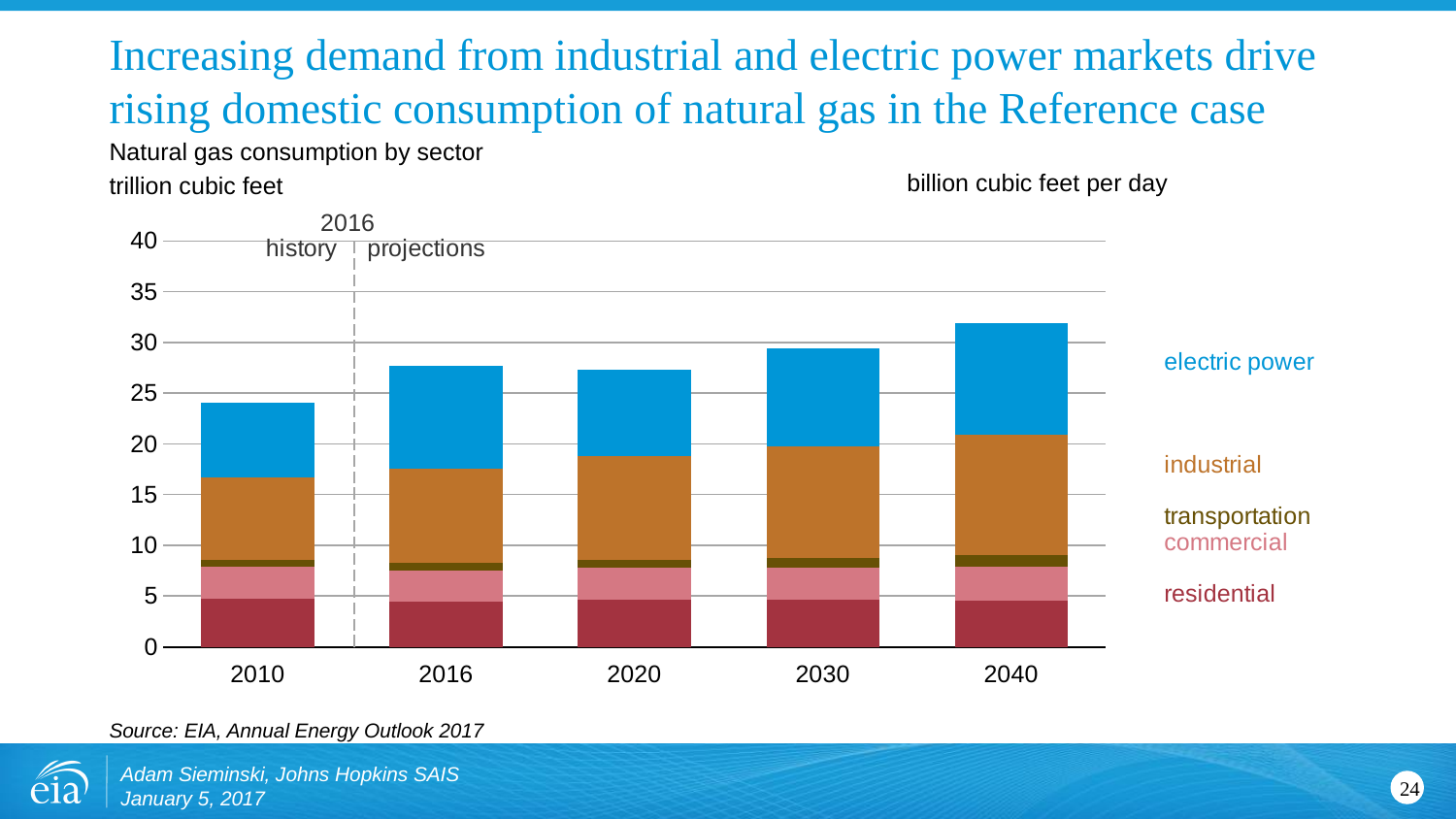
Which sector is shown at the top of each stacked bar? electric power Is the total natural gas consumption for 2040 greater or less than 30 trillion cubic feet? greater Do total natural gas consumption values generally rise or fall from 2010 to 2040? rise What is the title of the chart? Natural gas consumption by sector How many years are shown along the x axis of the chart? 5 Which year has the lowest total natural gas consumption in the chart? 2010 How many sectors (series) does the chart's legend list? 5 Is the total natural gas consumption for 2010 greater or less than 25 trillion cubic feet? less Is the total natural gas consumption for 2016 greater or less than 25 trillion cubic feet? greater Which year has the highest total natural gas consumption in the chart? 2040 Is the total natural gas consumption for 2040 larger or smaller than that for 2010? larger What kind of chart is shown on the slide? stacked bar chart